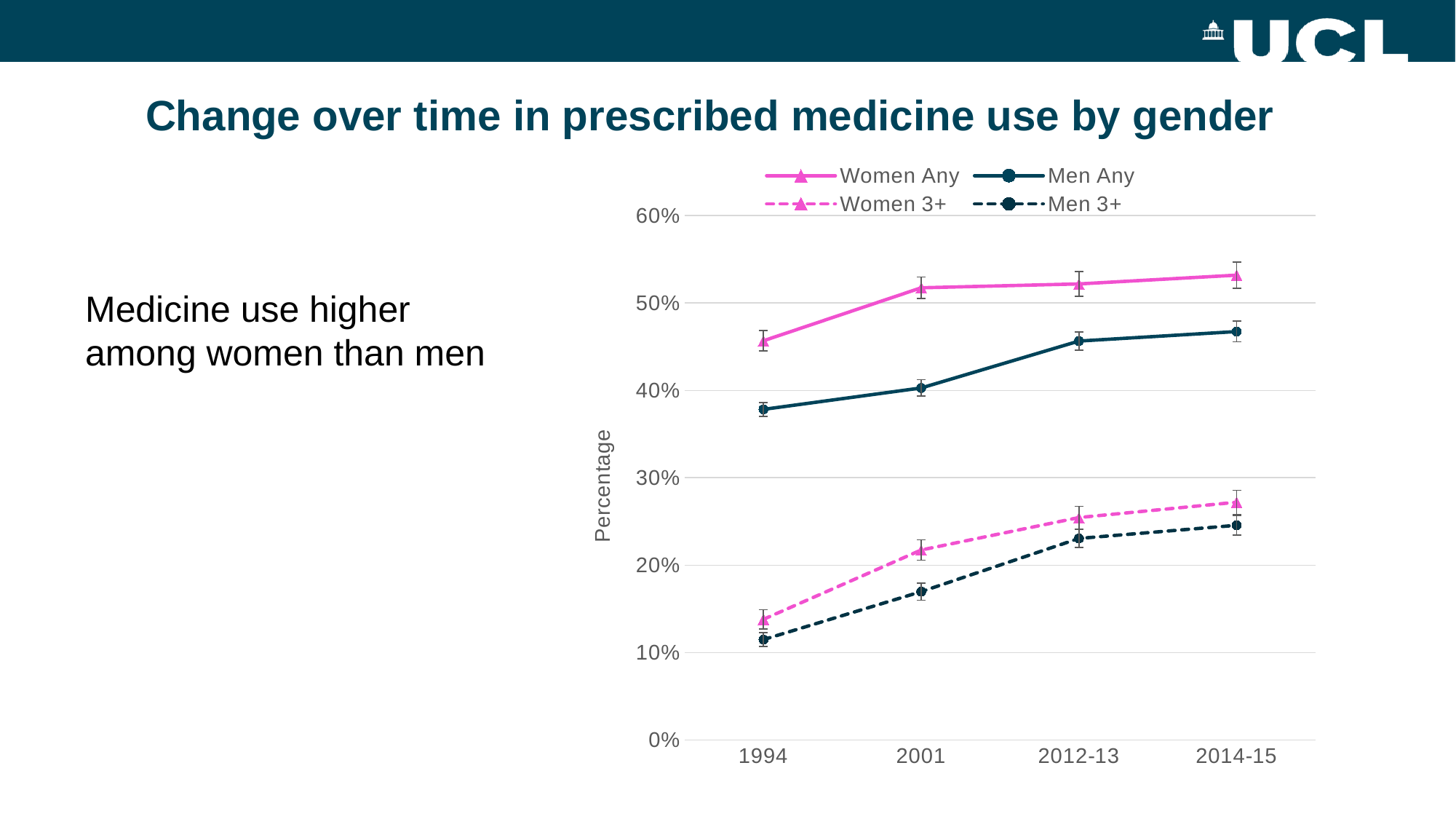
Is the value for Men 3+ in 2012-13 greater or less than 20%? greater Is the value for Men Any in 1994 greater or less than 40%? less Do the values for Men 3+ rise or fall from 1994 to 2014-15? Rise Is the value for Women Any in 1994 greater or less than 40%? greater What is the label on the y axis of the chart? Percentage Which series has the lowest value in 1994? Men 3+ Which series has the highest value in 2014-15? Women Any How many time points are shown on the x axis of the chart? 4 How many series does the chart legend list? 4 What kind of chart is shown on the slide? Line chart